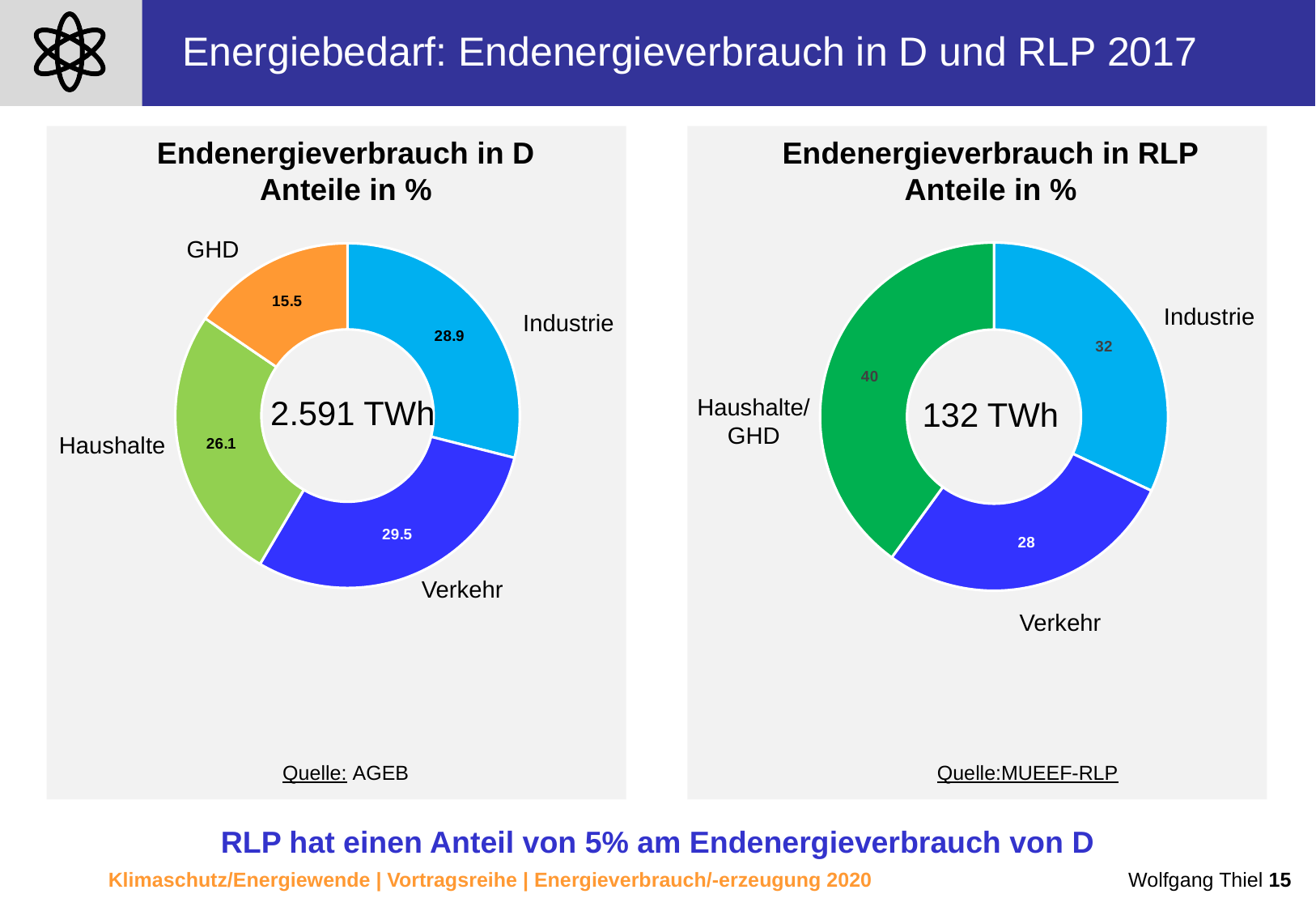
How many categories does the 'Endenergieverbrauch in D' chart show? 4 In the 'Endenergieverbrauch in D' chart, what is the value for Verkehr? 29.5 In the 'Endenergieverbrauch in RLP' chart, which category has the largest share? Haushalte/GHD In the 'Endenergieverbrauch in RLP' chart, which category has the smallest share? Verkehr In the 'Endenergieverbrauch in D' chart, which category has the smallest share? GHD What kind of chart is the 'Endenergieverbrauch in RLP' chart? Doughnut chart In the 'Endenergieverbrauch in RLP' chart, what is the value for Industrie? 32 In the 'Endenergieverbrauch in D' chart, which category has the largest share? Verkehr In the 'Endenergieverbrauch in D' chart, what is the value for GHD? 15.5 In the 'Endenergieverbrauch in RLP' chart, which is larger, Industrie or Verkehr? Industrie In the 'Endenergieverbrauch in D' chart, what is the difference between the Industrie and Haushalte values? 2.8 In the 'Endenergieverbrauch in RLP' chart, what is the difference between the Haushalte/GHD and Verkehr values? 12